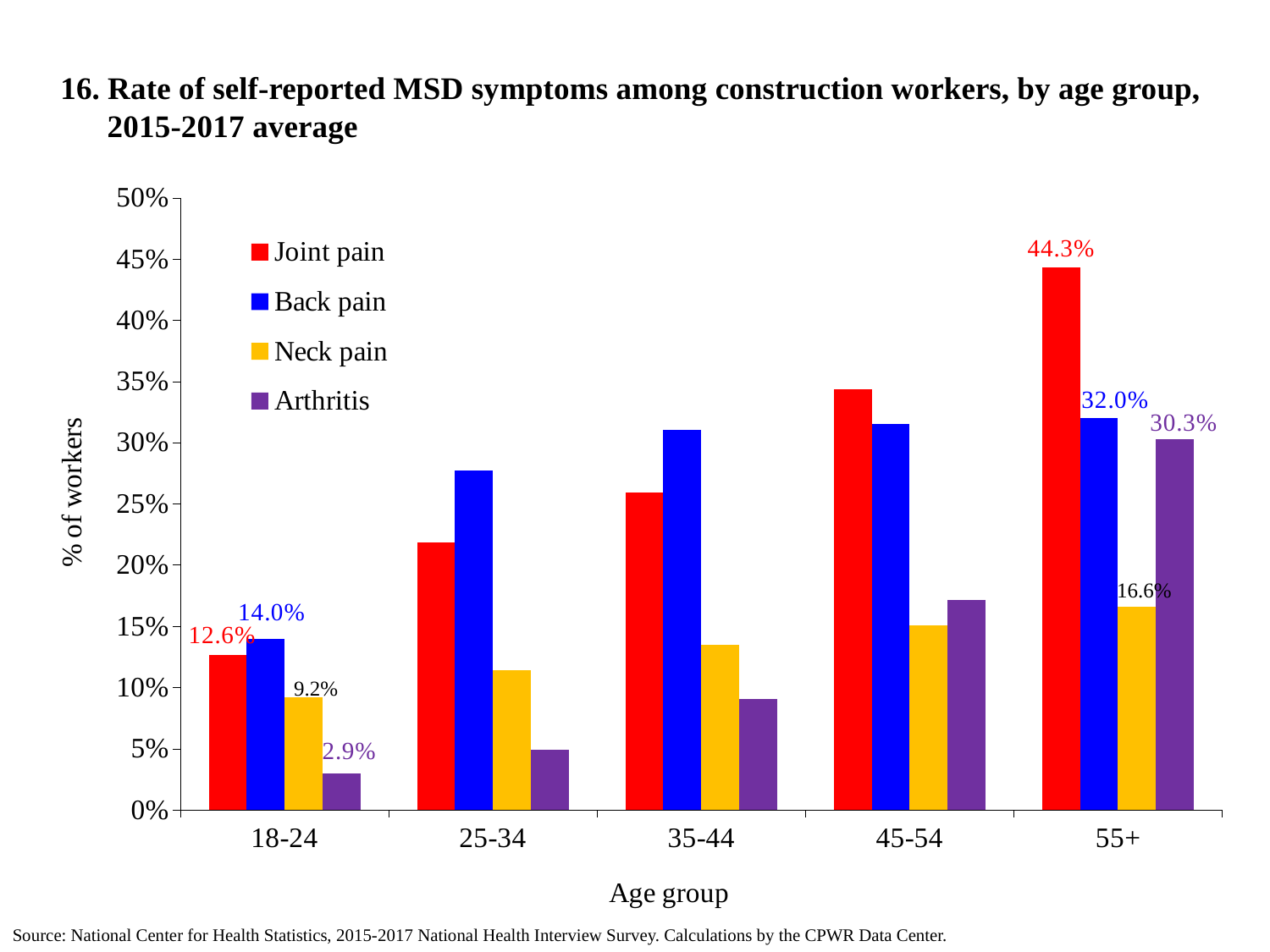
For the 55+ age group, which is larger: the back pain rate or the arthritis rate? Back pain Does the joint pain rate rise or fall as age group increases? rises How many series does the legend list? 4 Which symptom has the lowest rate among the 18-24 age group? Arthritis What is the rate of joint pain for the 55+ age group? 44.3% How much higher is the joint pain rate for the 55+ group than for the 18-24 group? 31.7 percentage points Is the back pain rate for the 25-34 age group greater or less than 25%? greater Is the neck pain rate for the 45-54 age group greater or less than 20%? less How many age groups are shown on the x axis? 5 Which age group has the highest rate of joint pain? 55+ What is the rate of neck pain for the 55+ age group? 16.6% What is the rate of arthritis for the 18-24 age group? 2.9%